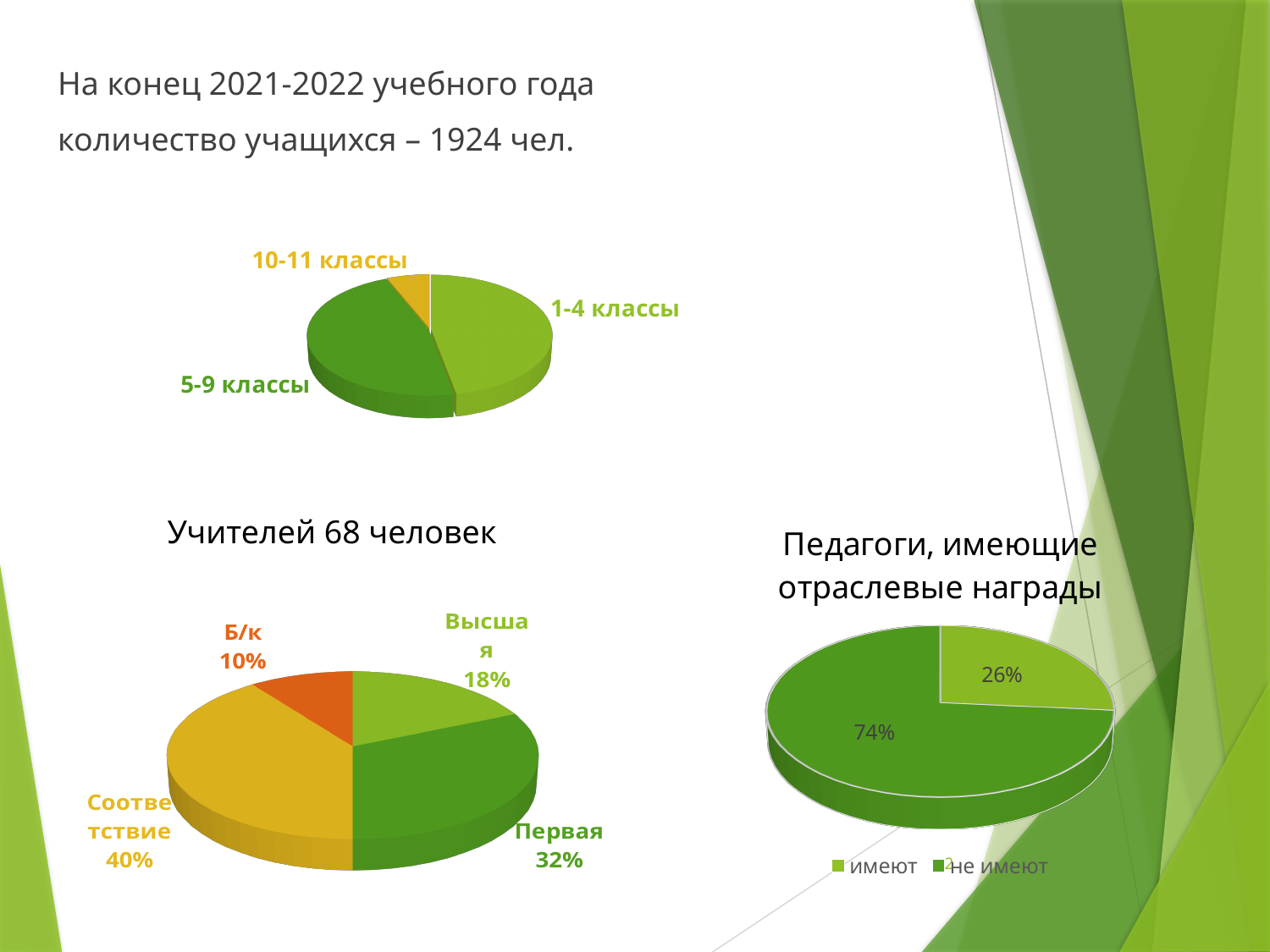
In the chart titled 'Педагоги, имеющие отраслевые награды', what share of teachers have awards ('имеют')? 26% How many pie charts are on the slide? 3 In the chart titled 'Учителей 68 человек', what share is labelled 'Б/к'? 10% In the top pie chart of students by class groups, which category has the smallest slice? 10-11 классы What type of chart is used for 'Педагоги, имеющие отраслевые награды'? pie chart In the top pie chart of students by class groups, which slice is larger: 5-9 классы or 10-11 классы? 5-9 классы In the chart titled 'Учителей 68 человек', what is the difference between the 'Соответствие' share and the 'Высшая' share? 22% In the chart titled 'Педагоги, имеющие отраслевые награды', which is larger: 'имеют' or 'не имеют'? не имеют In the chart titled 'Учителей 68 человек', what share is labelled 'Первая'? 32% In the top pie chart of students by class groups, how many categories are shown? 3 In the chart titled 'Учителей 68 человек', how many categories are shown? 4 In the chart titled 'Учителей 68 человек', which category has the largest share? Соответствие